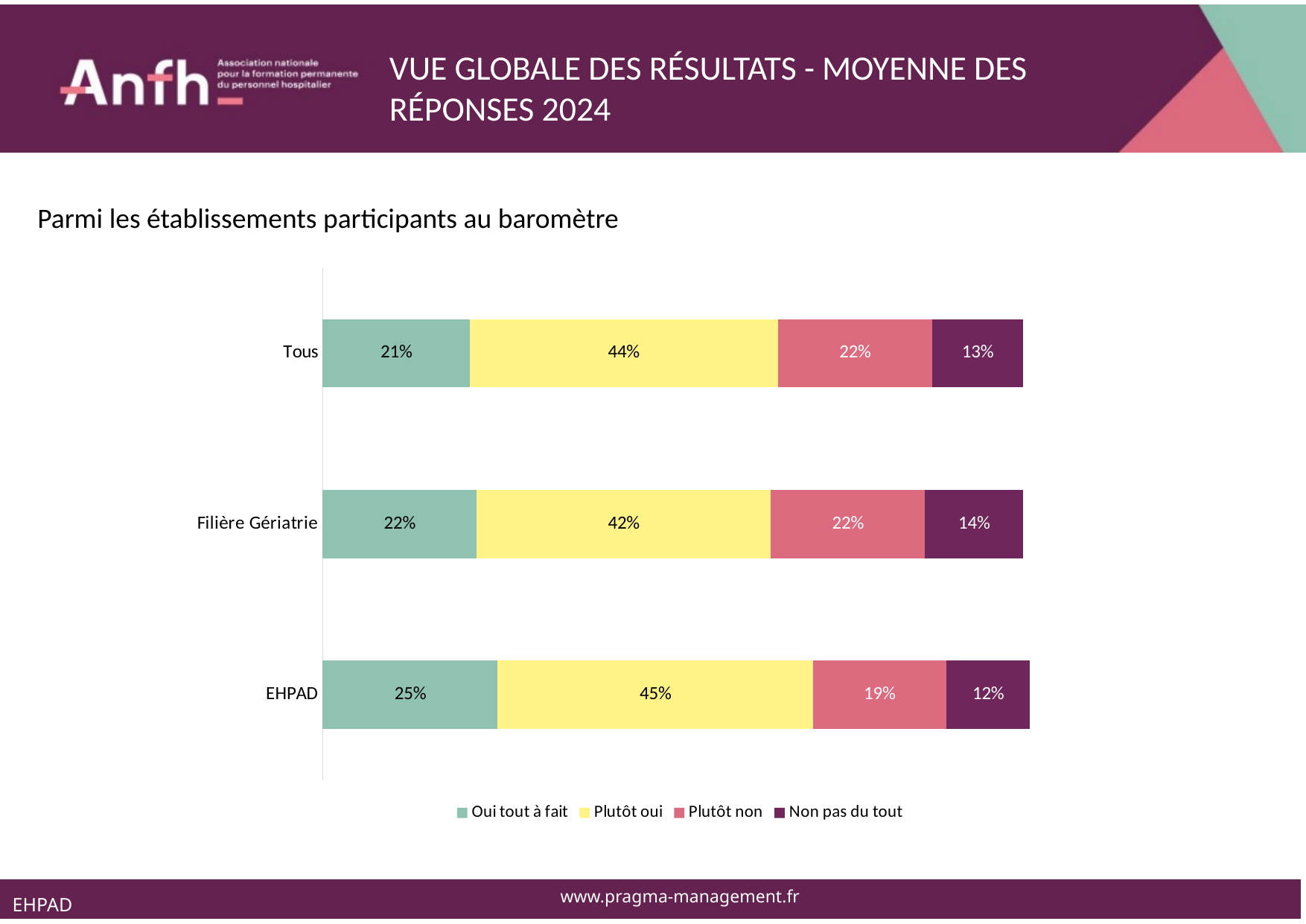
Which is larger: the "Non pas du tout" value for Tous or for Filière Gériatrie? Filière Gériatrie What is the value for "Oui tout à fait" in the EHPAD bar? 25% Which category has the highest value for "Oui tout à fait"? EHPAD What is the total of the EHPAD stacked bar? 101% How many series does the legend list? 4 What is the value for "Non pas du tout" in the Filière Gériatrie bar? 14% Which category has the lowest value for "Plutôt non"? EHPAD What is the difference between the "Plutôt oui" values for EHPAD and Filière Gériatrie? 3% How many categories are shown on the chart? 3 What is the value for "Plutôt oui" in the Tous bar? 44% What kind of chart is shown on the slide? Stacked bar chart What is the value for "Plutôt non" in the EHPAD bar? 19%